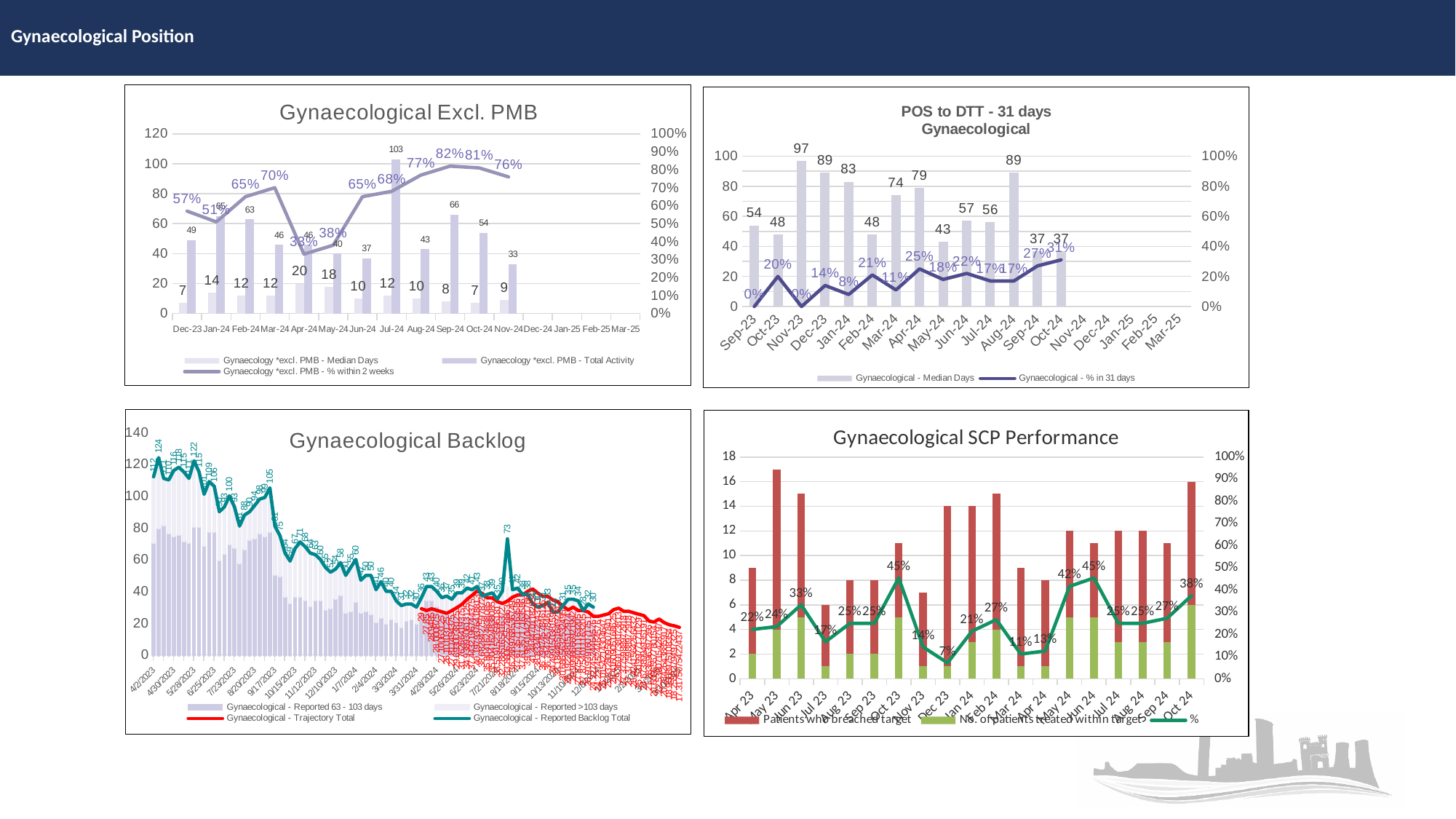
In the 'POS to DTT - 31 days Gynaecological' chart, what is the % in 31 days for Oct-24? 31% In the 'Gynaecological SCP Performance' chart, what is the % value for Oct 24? 38% In the 'Gynaecological Excl. PMB' chart, what is the Total Activity value for Jul-24? 103 How many series does the legend of the 'Gynaecological SCP Performance' chart list? 3 In the 'Gynaecological Excl. PMB' chart, which month has the highest Median Days value? Apr-24 In the 'Gynaecological Excl. PMB' chart, what is the difference between the Total Activity for Jul-24 and Nov-24? 70 How many series does the legend of the 'Gynaecological Backlog' chart list? 4 In the 'POS to DTT - 31 days Gynaecological' chart, what is the Median Days value for Nov-23? 97 In the 'POS to DTT - 31 days Gynaecological' chart, which month has the lowest Median Days value? Sep-24 and Oct-24 (both 37) In the 'Gynaecological SCP Performance' chart, which month has the lowest % value? Dec 23 In the 'POS to DTT - 31 days Gynaecological' chart, is the Median Days value for Aug-24 greater or less than the value for May-24? greater In the 'Gynaecological Excl. PMB' chart, what is the % within 2 weeks for Sep-24? 82%